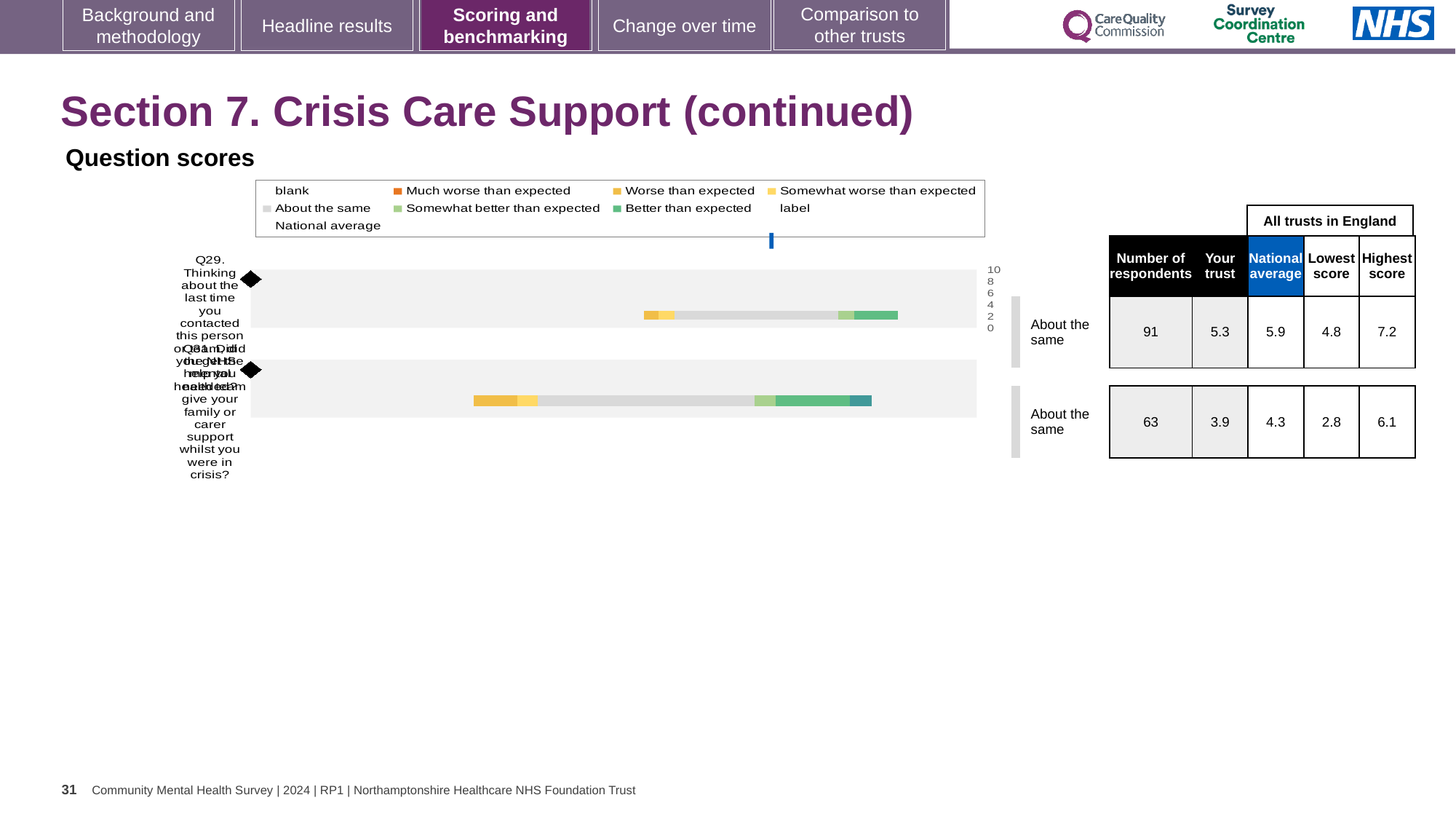
Which legend entry is shown in orange? Much worse than expected What is the highest tick value shown on the chart's axis? 10 What kind of chart is shown under "Question scores"? bar chart How many question bars are plotted in the chart? 2 Which legend entry is shown in light grey? About the same How many entries does the chart legend list? 9